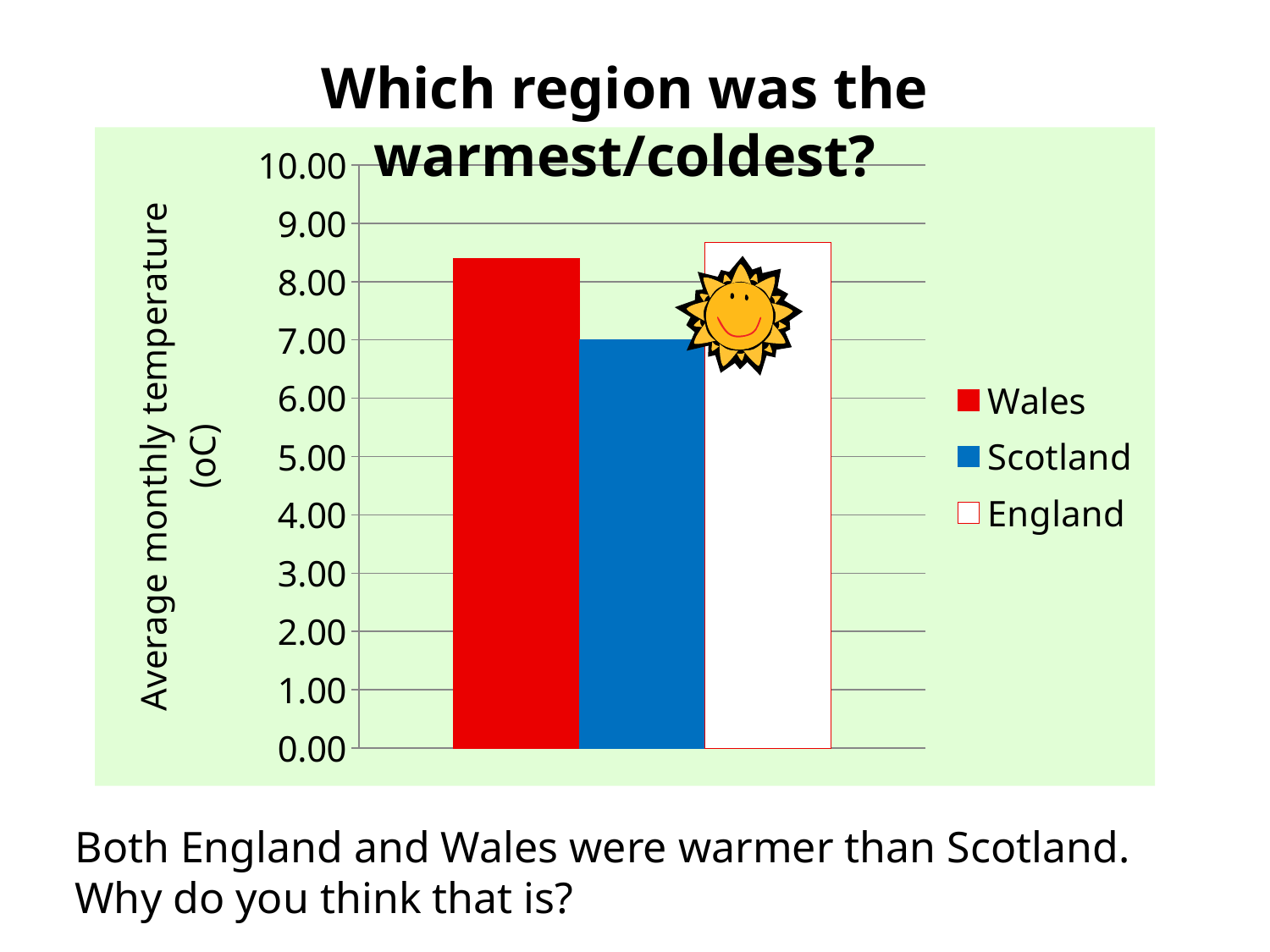
What kind of chart is shown on the slide? bar chart Which is larger, the value for Wales or the value for Scotland? Wales Is the value for Scotland greater or less than 8.00? less What is the label on the vertical axis of the chart? Average monthly temperature (oC) Which region has the lowest average monthly temperature? Scotland How many series does the legend list? 3 Which colour represents Scotland in the legend? blue Which region has the highest average monthly temperature? England Is the value for Wales greater or less than 8.00? greater Is the value for England greater or less than 9.00? less How many bars are plotted in the chart? 3